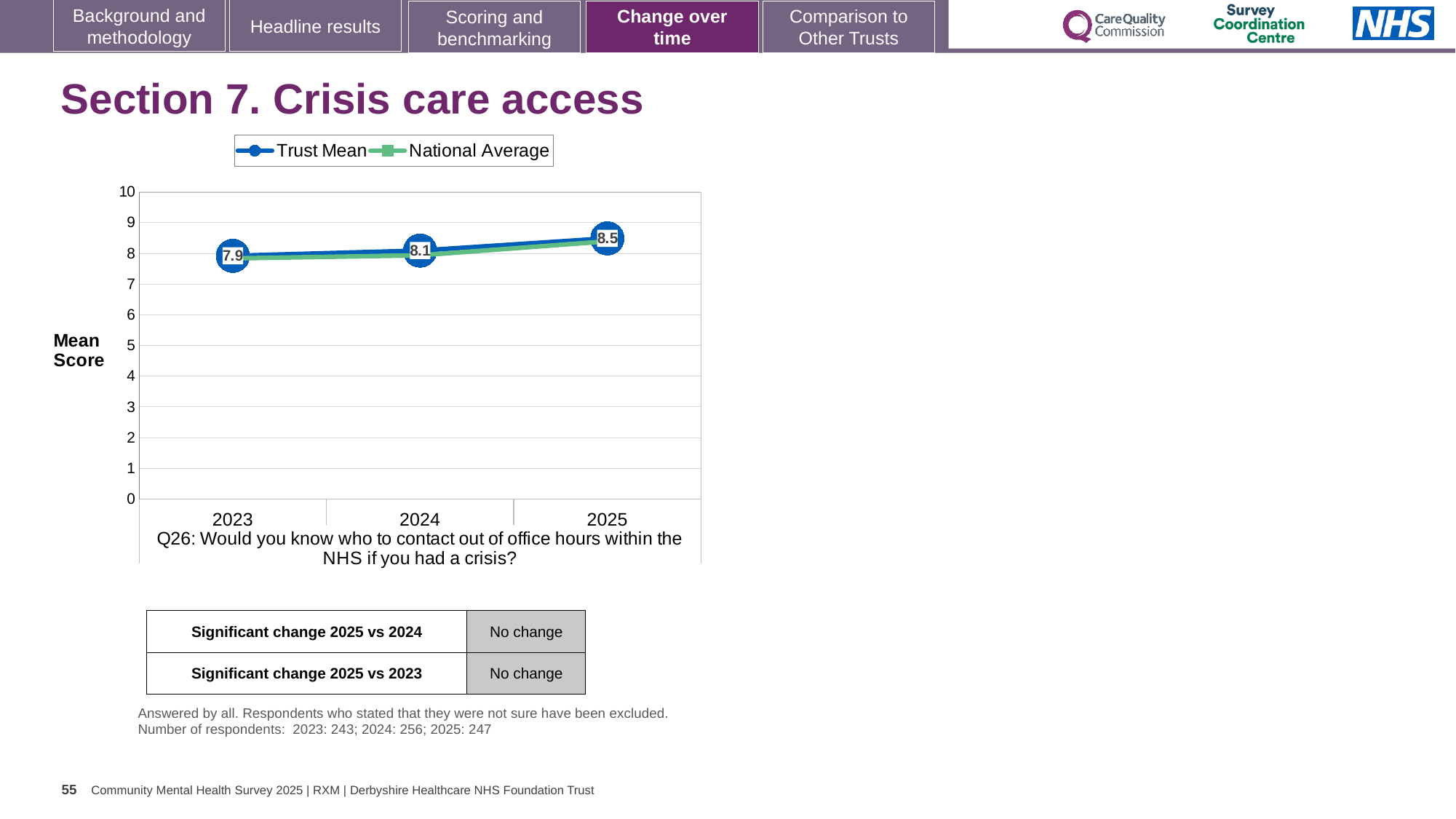
What is the Trust Mean score for 2025? 8.5 Does the Trust Mean score rise or fall from 2023 to 2025? Rise What is the Trust Mean score for 2024? 8.1 Is the Trust Mean score for 2024 larger than the Trust Mean score for 2023? Yes In which year is the Trust Mean score lowest? 2023 How many years are shown on the x axis? 3 How many series does the legend list? 2 What is the difference between the Trust Mean score in 2025 and in 2023? 0.6 What is the Trust Mean score for 2023? 7.9 In which year is the Trust Mean score highest? 2025 Is the National Average value for 2025 greater or less than 5? greater What kind of chart is shown on the slide? Line chart